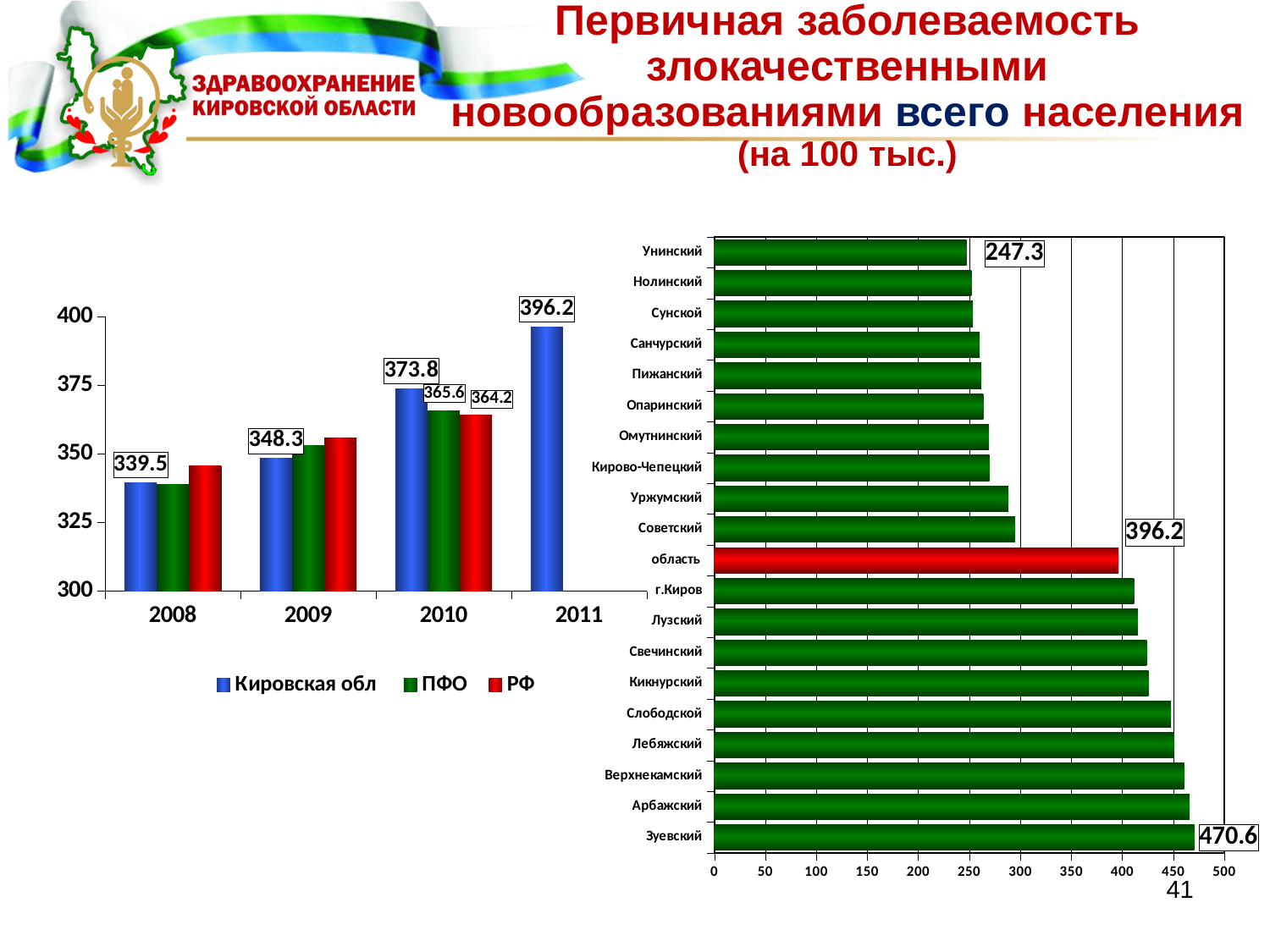
On the left chart, how many series does the legend list? 3 On the right chart, what is the difference between the values for Зуевский and Унинский? 223.3 On the right chart, which district has the lowest value? Унинский On the left chart, does the Кировская обл value rise or fall from 2008 to 2011? rise On the left chart, what is the value for ПФО in 2010? 365.6 On the left chart, what is the difference between the Кировская обл values for 2011 and 2008? 56.7 On the right chart, what is the value for область? 396.2 On the left chart, is the value for РФ in 2009 greater or less than 350? greater On the left chart, what is the value for РФ in 2010? 364.2 On the right chart, which district has the highest value? Зуевский On the left chart, what is the value for Кировская обл in 2011? 396.2 On the left chart, what is the value for Кировская обл in 2008? 339.5